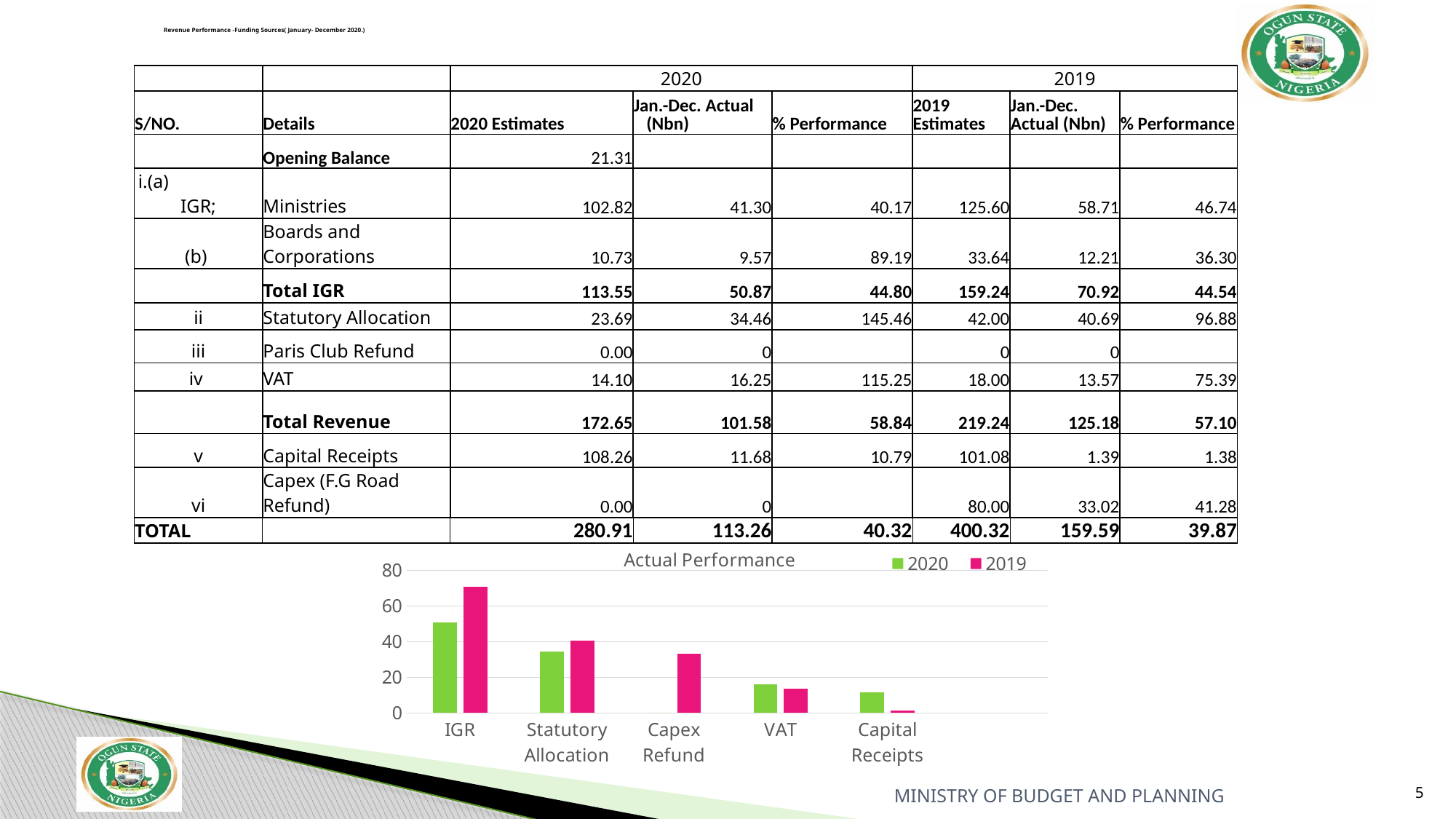
How many series does the chart legend list? 2 For VAT, which series has the larger value, 2020 or 2019? 2020 How many categories are shown on the x axis of the chart? 5 Is the 2019 value for IGR greater or less than 60? greater Which category has the highest 2020 value in the chart? IGR What is the title of the chart? Actual Performance Which category has the lowest 2019 value in the chart? Capital Receipts Which colour represents the 2019 series in the chart? Pink For IGR, which series has the larger value, 2020 or 2019? 2019 Is the 2019 value for Capex Refund greater or less than 20? greater What kind of chart is shown on the slide? Bar chart Which category has the highest 2019 value in the chart? IGR